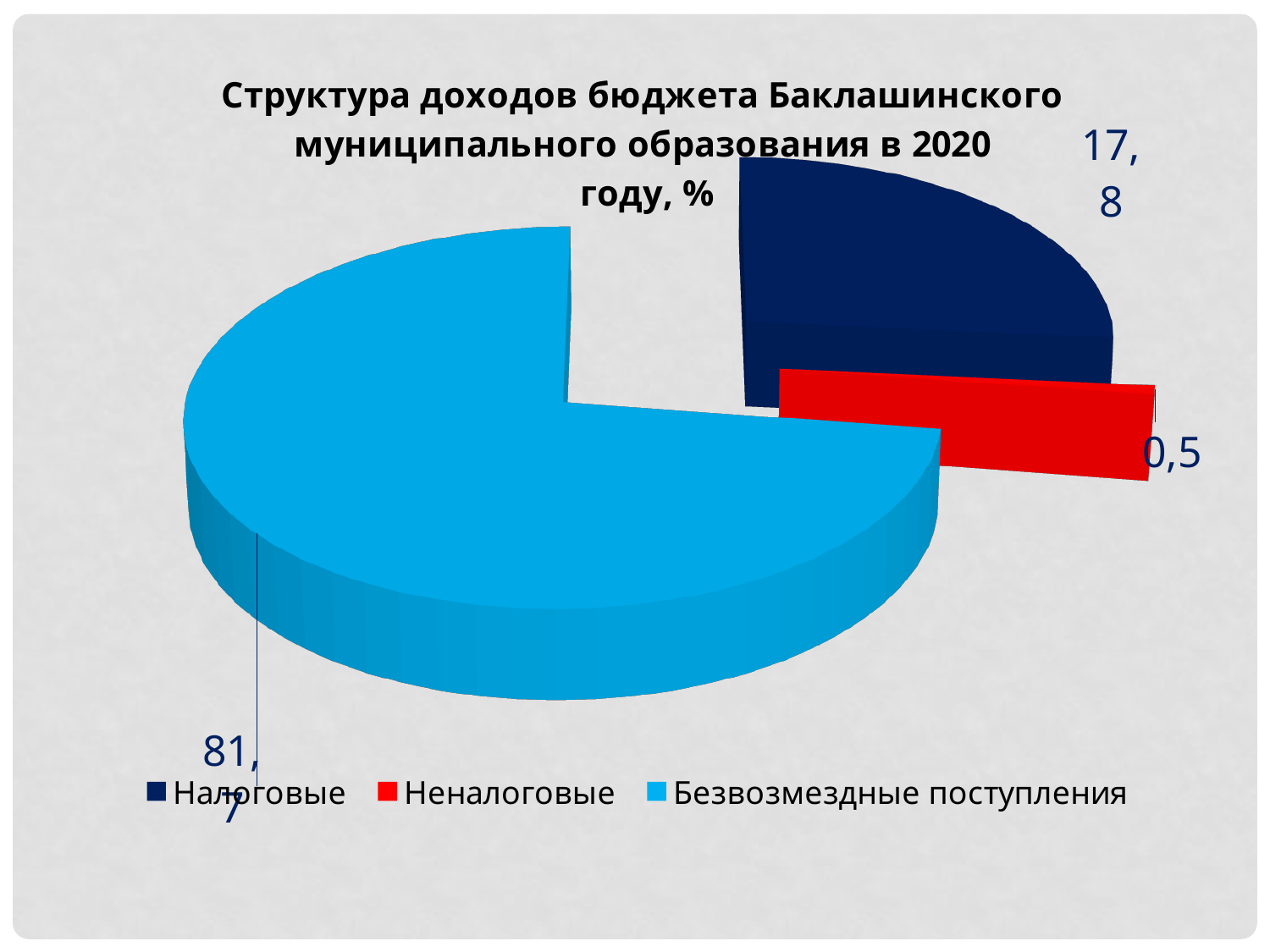
What is the value for Безвозмездные поступления? 81,7 What is the value for Неналоговые? 0,5 What is the value for Налоговые? 17,8 What is the title of the chart? Структура доходов бюджета Баклашинского муниципального образования в 2020 году, % What kind of chart is shown on the slide? pie chart What colour is the slice for Неналоговые? red What is the difference between the values for Безвозмездные поступления and Налоговые? 63,9 Which category has the largest slice of the pie? Безвозмездные поступления How many categories does the pie chart have? 3 What is the difference between the values for Налоговые and Неналоговые? 17,3 Which category has the smallest slice of the pie? Неналоговые Which is larger, the value for Налоговые or the value for Неналоговые? Налоговые